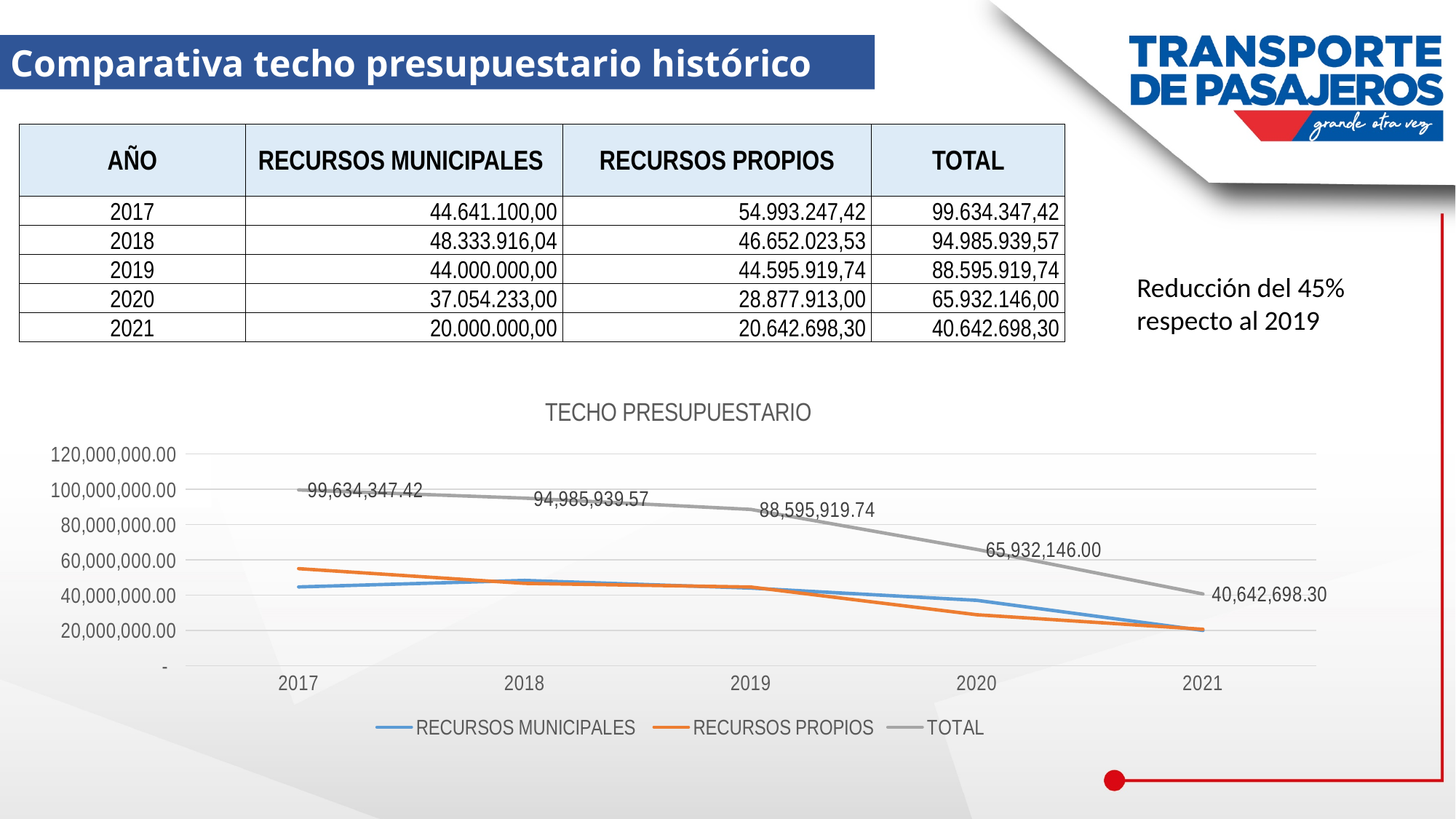
Does the TOTAL series rise or fall from 2017 to 2021 in the TECHO PRESUPUESTARIO chart? Fall In which year is the TOTAL series highest in the TECHO PRESUPUESTARIO chart? 2017 In 2017, which is larger in the TECHO PRESUPUESTARIO chart: RECURSOS MUNICIPALES or RECURSOS PROPIOS? RECURSOS PROPIOS Is the value for RECURSOS PROPIOS in 2020 greater or less than 40,000,000.00 in the TECHO PRESUPUESTARIO chart? less How many years are plotted on the x axis of the TECHO PRESUPUESTARIO chart? 5 What is the TOTAL value labelled for 2017 in the TECHO PRESUPUESTARIO chart? 99,634,347.42 In which year is the TOTAL series lowest in the TECHO PRESUPUESTARIO chart? 2021 How many series does the legend of the TECHO PRESUPUESTARIO chart list? 3 What is the TOTAL value labelled for 2021 in the TECHO PRESUPUESTARIO chart? 40,642,698.30 What is the TOTAL value labelled for 2020 in the TECHO PRESUPUESTARIO chart? 65,932,146.00 What type of chart is shown under the title TECHO PRESUPUESTARIO? Line chart What is the difference between the TOTAL values for 2017 and 2021 in the TECHO PRESUPUESTARIO chart? 58,991,649.12